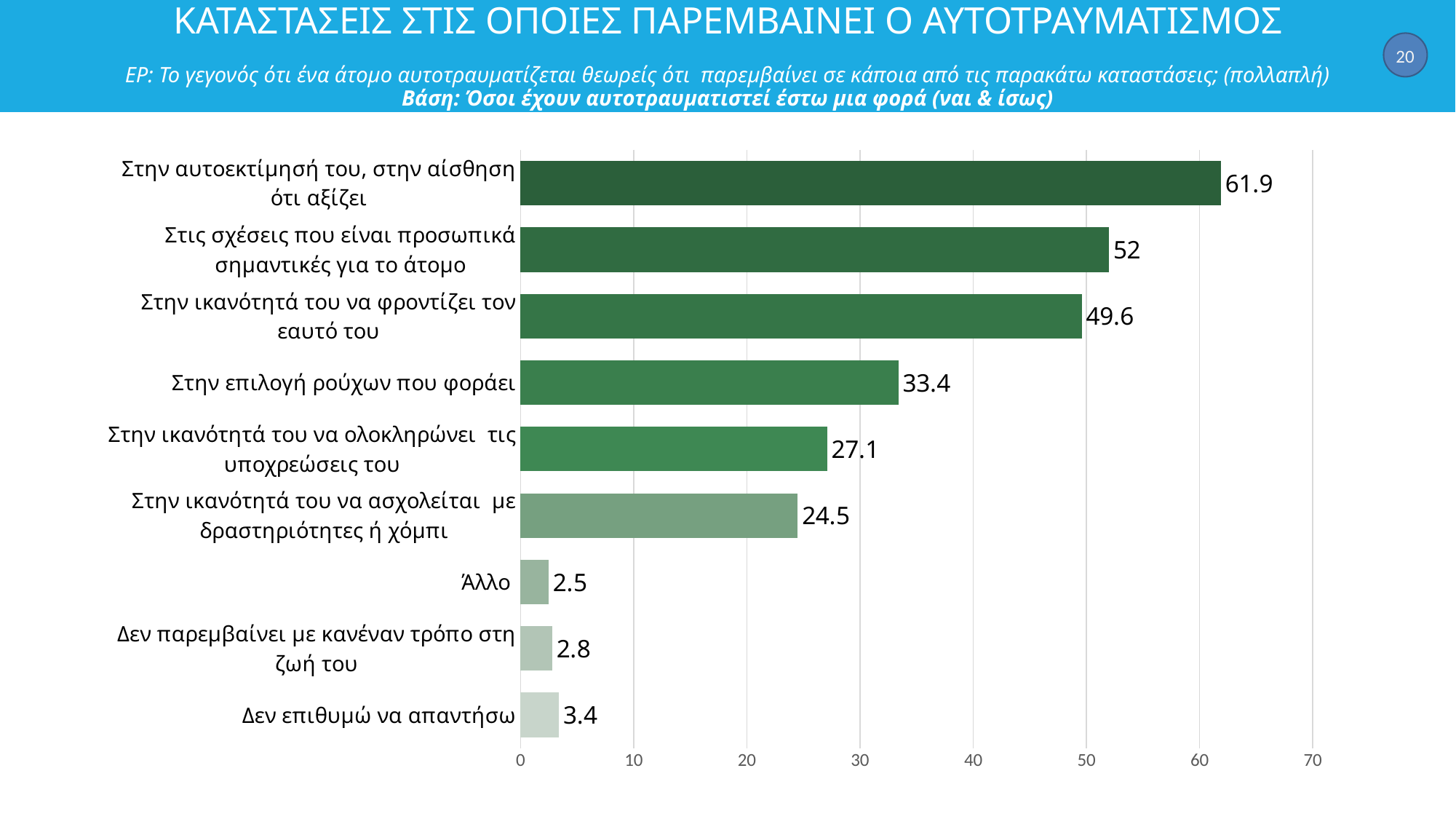
What is the value for 'Στην επιλογή ρούχων που φοράει'? 33.4 What kind of chart is shown on the slide? Bar chart What is the difference between 'Δεν παρεμβαίνει με κανέναν τρόπο στη ζωή του' and 'Άλλο'? 0.3 Which category has the lowest value? Άλλο What is the difference between 'Στις σχέσεις που είναι προσωπικά σημαντικές για το άτομο' and 'Στην ικανότητά του να φροντίζει τον εαυτό του'? 2.4 Which category has the highest value? Στην αυτοεκτίμησή του, στην αίσθηση ότι αξίζει What is the value for 'Στην αυτοεκτίμησή του, στην αίσθηση ότι αξίζει'? 61.9 Which is larger: 'Στην ικανότητά του να ολοκληρώνει τις υποχρεώσεις του' or 'Στην ικανότητά του να ασχολείται με δραστηριότητες ή χόμπι'? Στην ικανότητά του να ολοκληρώνει τις υποχρεώσεις του How many categories are shown in the chart? 9 What is the maximum value shown on the x axis? 70 What is the value for 'Δεν επιθυμώ να απαντήσω'? 3.4 Is the value for 'Στην επιλογή ρούχων που φοράει' greater or less than 30? greater